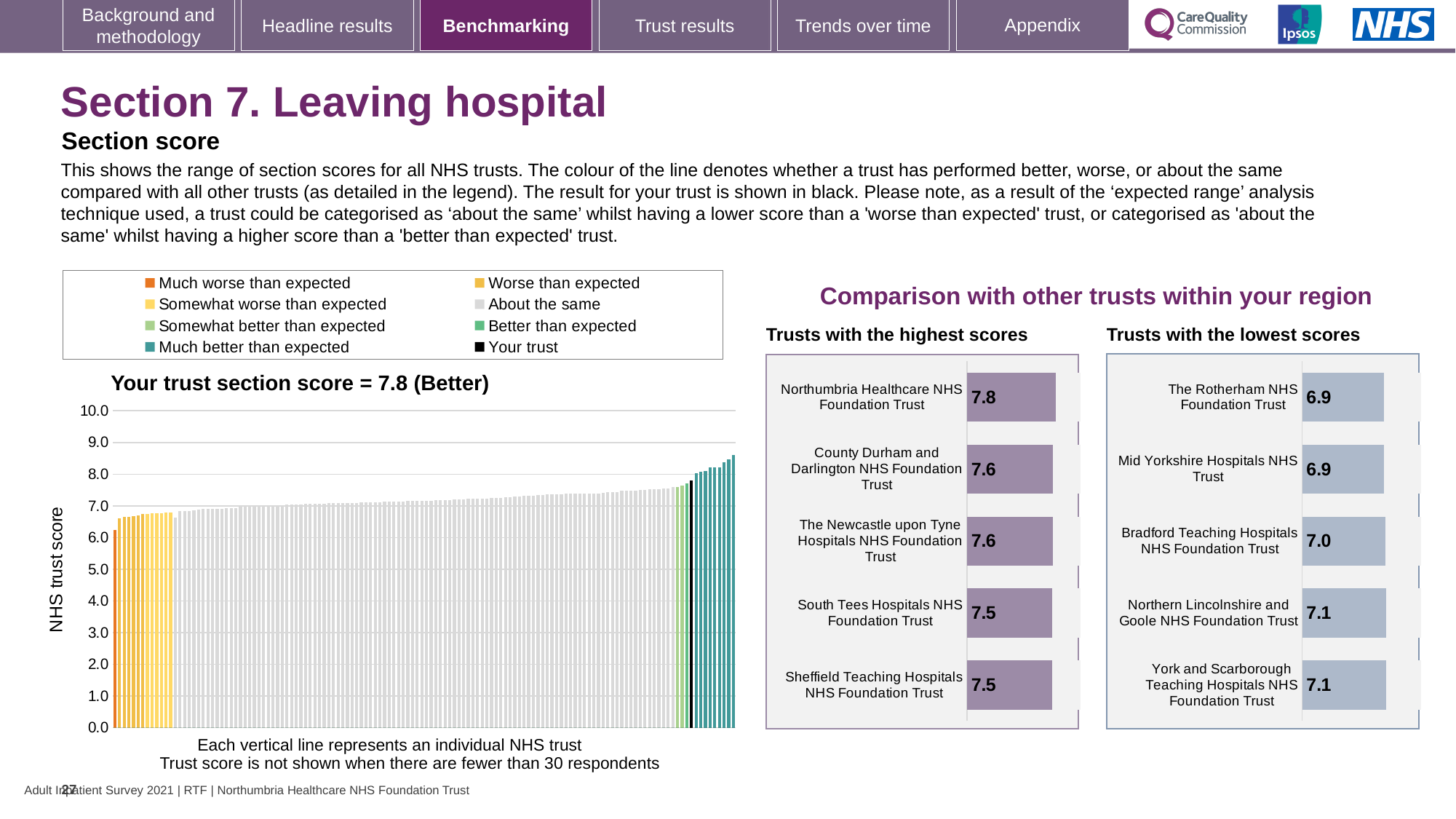
In the 'Trusts with the highest scores' chart, which trust has the highest score? Northumbria Healthcare NHS Foundation Trust What kind of chart is the 'Your trust section score = 7.8 (Better)' chart? Bar chart In the 'Your trust section score' chart, is the value of the lowest (leftmost) bar greater or less than 7.0? less In the 'Trusts with the highest scores' chart, what is the difference between the scores of Northumbria Healthcare NHS Foundation Trust and Sheffield Teaching Hospitals NHS Foundation Trust? 0.3 In the 'Trusts with the lowest scores' chart, what is the score for The Rotherham NHS Foundation Trust? 6.9 In the 'Trusts with the lowest scores' chart, what is the difference between the scores of York and Scarborough Teaching Hospitals NHS Foundation Trust and Mid Yorkshire Hospitals NHS Trust? 0.2 In the 'Trusts with the highest scores' chart, what is the score for Northumbria Healthcare NHS Foundation Trust? 7.8 How many entries does the legend above the 'Your trust section score' chart list? 8 Which is larger: the score for County Durham and Darlington NHS Foundation Trust in the 'Trusts with the highest scores' chart, or the score for Northern Lincolnshire and Goole NHS Foundation Trust in the 'Trusts with the lowest scores' chart? County Durham and Darlington NHS Foundation Trust In the 'Trusts with the lowest scores' chart, what is the score for Bradford Teaching Hospitals NHS Foundation Trust? 7.0 In the 'Trusts with the highest scores' chart, what is the score for South Tees Hospitals NHS Foundation Trust? 7.5 How many trusts are listed in the 'Trusts with the lowest scores' chart? 5